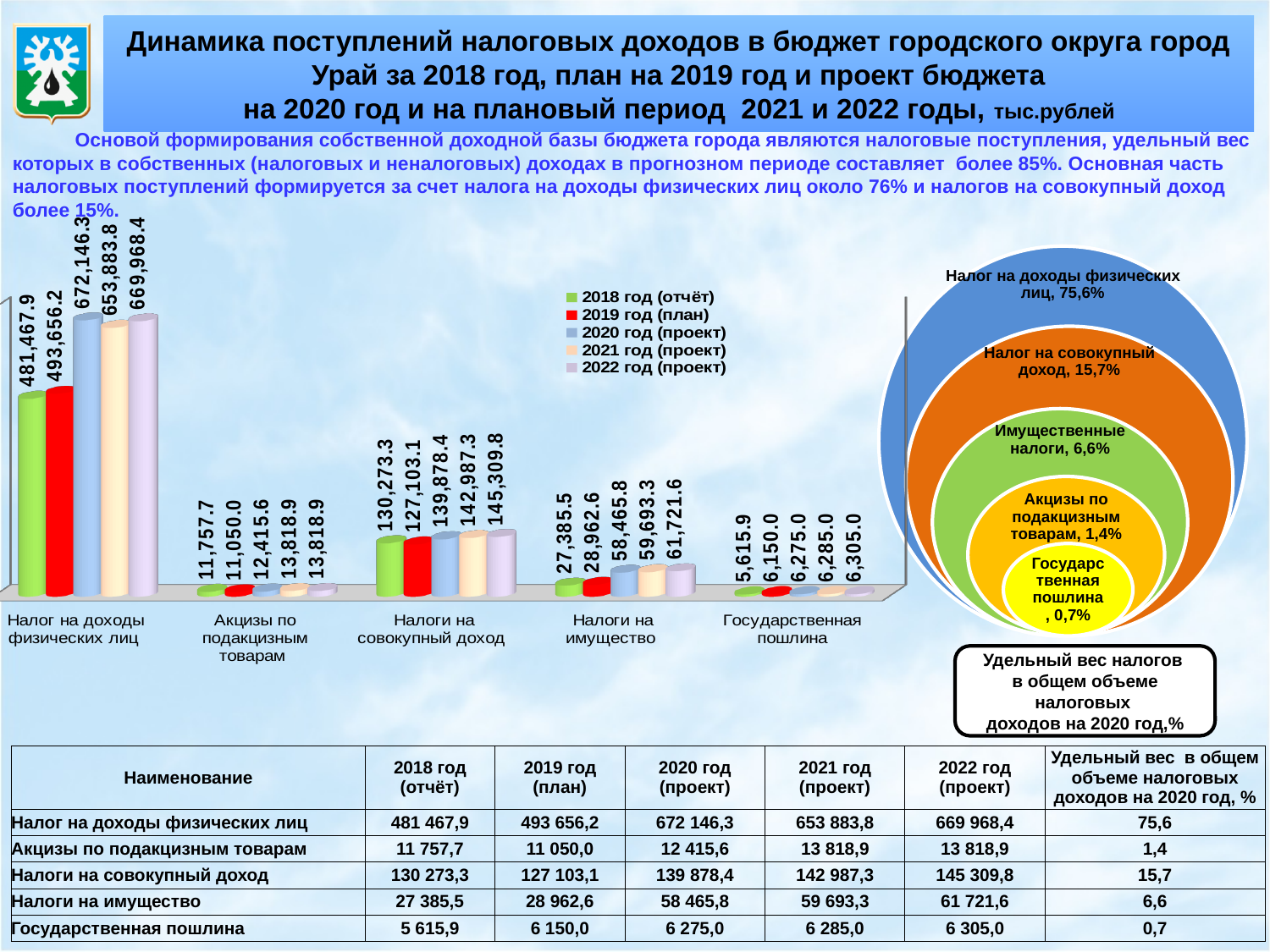
In the bar chart, do the values for Государственная пошлина rise or fall from 2018 to 2022? rise What kind of chart is the chart on the left side of the slide? bar chart In the bar chart, how many tax categories are shown along the x axis? 5 In the bar chart, what is the difference between the 2022 год (проект) and 2018 год (отчёт) values for Налоги на совокупный доход? 15,036.5 In the bar chart, which category has the lowest value for 2018 год (отчёт)? Государственная пошлина In the bar chart, which category has the highest value for 2022 год (проект)? Налог на доходы физических лиц In the circle chart on the right, what share does Налог на совокупный доход have? 15,7% In the bar chart, for Налог на доходы физических лиц, which is larger: the 2020 год (проект) value or the 2021 год (проект) value? 2020 год (проект) In the bar chart, how many series does the legend list? 5 In the circle chart on the right, which tax has the smallest share? Государственная пошлина In the bar chart, what is the value for Налог на доходы физических лиц in 2020 год (проект)? 672,146.3 In the bar chart, what is the value for Налоги на имущество in 2019 год (план)? 28,962.6